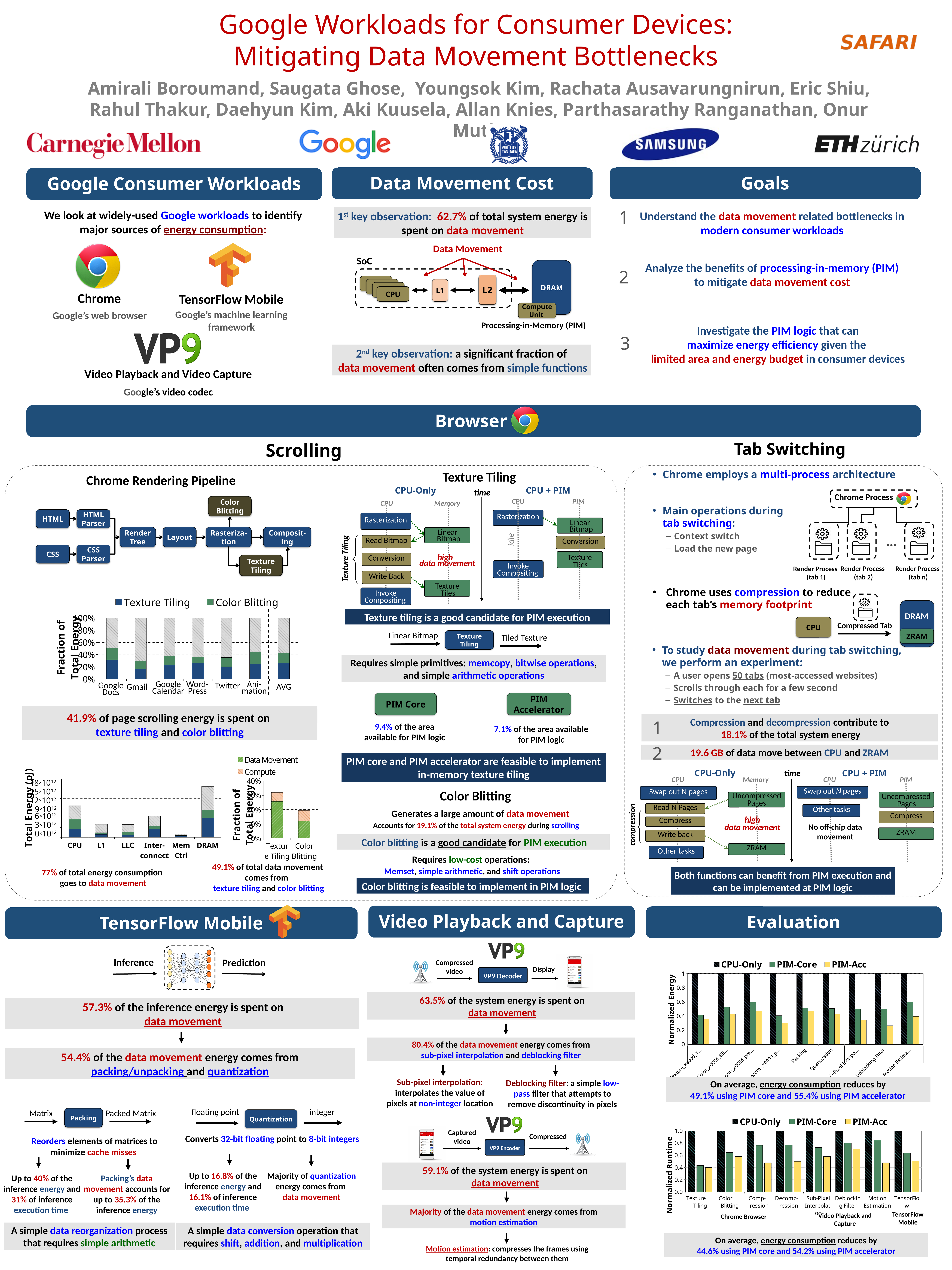
In the Evaluation section's Normalized Energy chart, what kind of chart is it? bar chart In the Normalized Runtime chart in the Evaluation section, is the PIM-Acc value for Texture Tiling greater or less than 0.6? less In the Total Energy (pJ) chart in the Scrolling section, which category has the highest total energy? DRAM In the Normalized Runtime chart in the Evaluation section, for Motion Estimation, which is larger: PIM-Core or PIM-Acc? PIM-Core In the Normalized Runtime chart in the Evaluation section, what are the legend entries? CPU-Only, PIM-Core, PIM-Acc In the Normalized Energy chart in the Evaluation section, is the PIM-Acc value for Deblocking Filter greater or less than 0.4? less In the Fraction of Total Energy chart in the Scrolling section with Texture Tiling and Color Blitting stacked bars, how many categories are shown on the x axis? 7 In the Normalized Energy chart in the Evaluation section, what is the CPU-Only value for Packing? 1 In the Normalized Runtime chart in the Evaluation section, is the PIM-Core value for Motion Estimation greater or less than 0.6? greater In the Normalized Runtime chart in the Evaluation section, how many series does the legend list? 3 In the Total Energy (pJ) chart in the Scrolling section, which category has the lowest total energy? Mem Ctrl In the Normalized Runtime chart in the Evaluation section, how many categories are shown on the x axis? 8